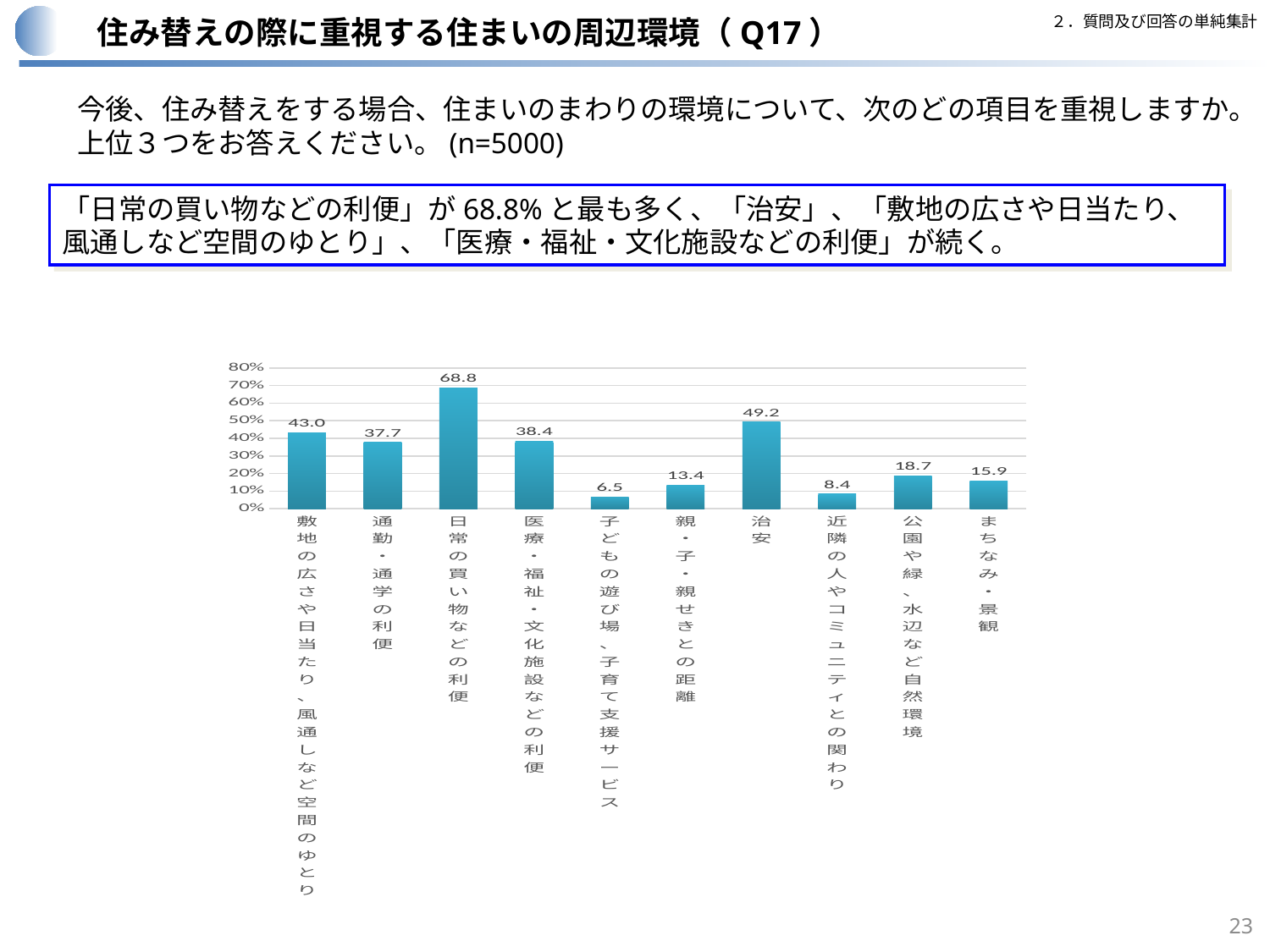
What is the difference between the values for 日常の買い物などの利便 and 治安? 19.6 What is the value for 治安? 49.2 What is the value for 日常の買い物などの利便? 68.8 What is the value for 公園や緑、水辺など自然環境? 18.7 How many categories are shown in the chart? 10 Which is larger, the value for 通勤・通学の利便 or the value for 医療・福祉・文化施設などの利便? 医療・福祉・文化施設などの利便 Is the value for 敷地の広さや日当たり、風通しなど空間のゆとり greater or less than 40%? greater What is the maximum value shown on the vertical axis? 80% Which category has the lowest value? 子どもの遊び場、子育て支援サービス Which category has the highest value? 日常の買い物などの利便 What kind of chart is shown on the slide? bar chart What is the value for 子どもの遊び場、子育て支援サービス? 6.5